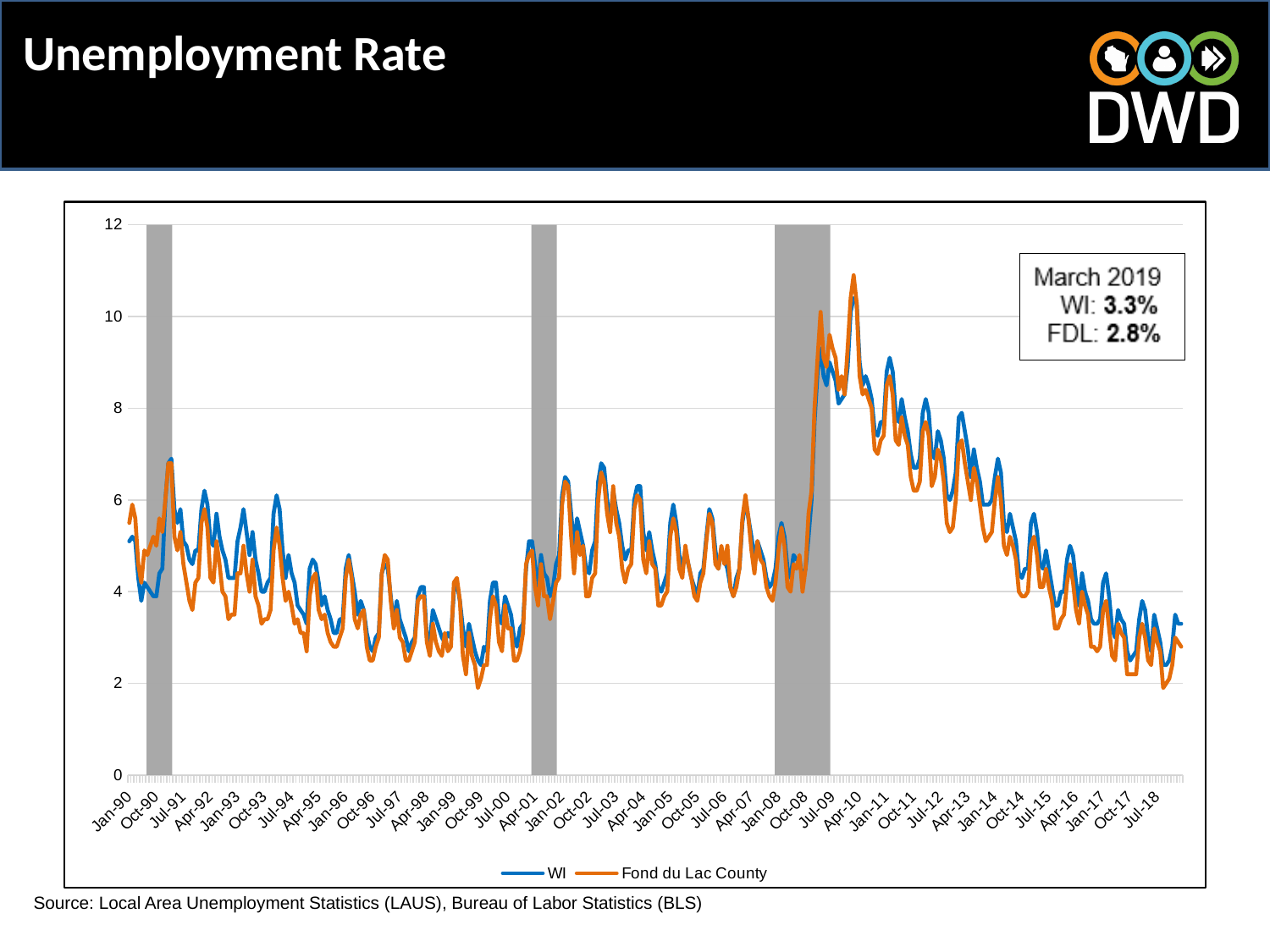
Is the peak value of the Fond du Lac County line around Apr-10 greater or less than 10? greater What kind of chart is shown on the slide? Line chart Is the peak value of the WI line around 2009-2010 greater or less than 10? greater What is the title of the slide containing the chart? Unemployment Rate What is the unemployment rate for Fond du Lac County (FDL) in March 2019? 2.8% Do the unemployment rates rise or fall between Jan-08 and Jul-09? rise Do the unemployment rates generally rise or fall between Jan-10 and Jul-18? fall In March 2019, which has the higher unemployment rate, WI or Fond du Lac County? WI Which colour represents Fond du Lac County in the chart? Orange What is the difference between the WI and FDL unemployment rates in March 2019? 0.5 percentage points What is the unemployment rate for WI in March 2019? 3.3% How many series does the chart's legend list? 2